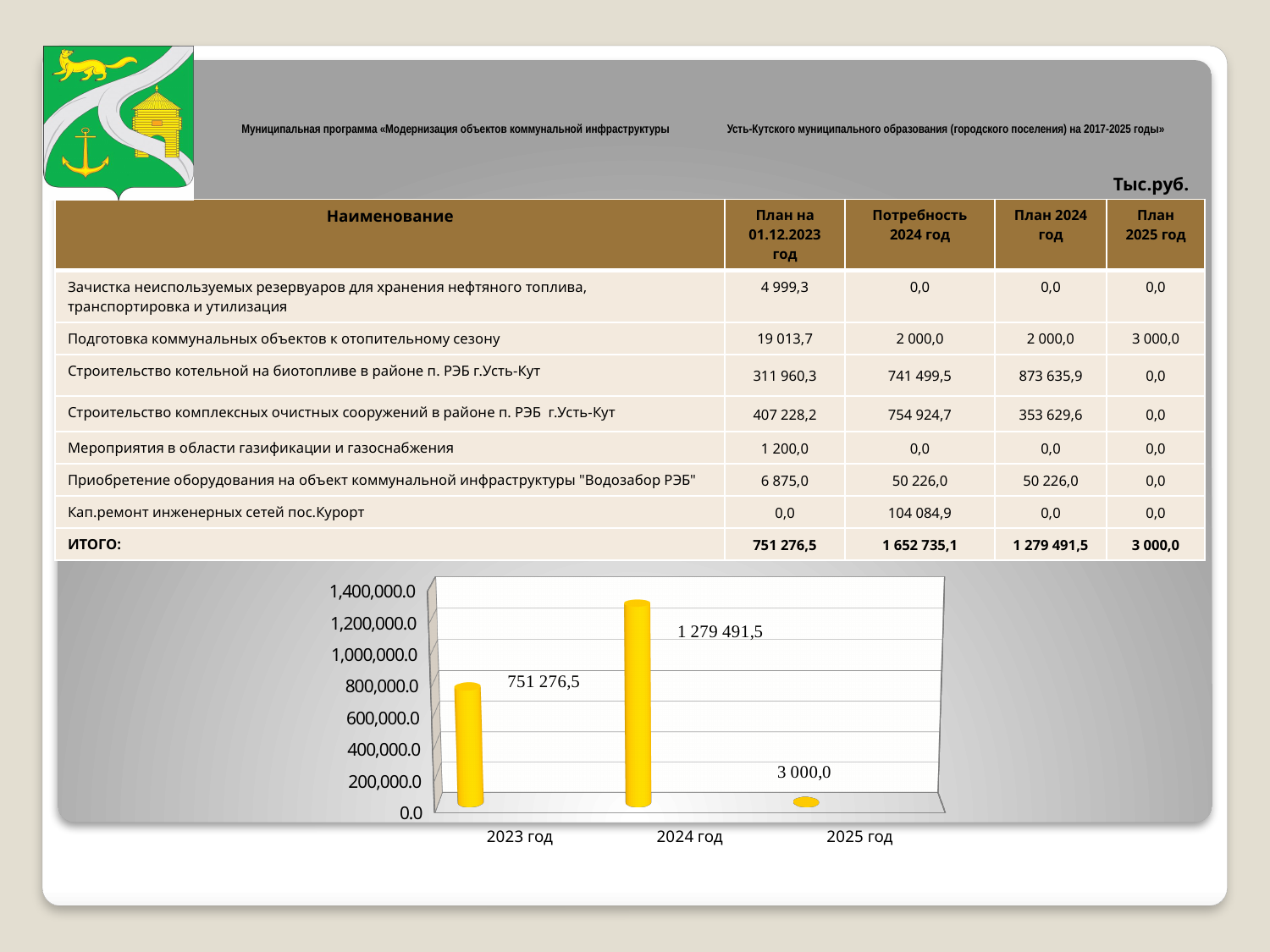
What is the value shown for 2025 год in the chart? 3 000,0 Which year has the lowest value in the chart? 2025 год What is the difference between the values for 2024 год and 2023 год in the chart? 528 215,0 Which year has the highest value in the chart? 2024 год What is the value shown for 2023 год in the chart? 751 276,5 What is the highest tick value shown on the vertical axis of the chart? 1,400,000.0 What is the value shown for 2024 год in the chart? 1 279 491,5 Is the value for 2024 год in the chart greater or less than 1,200,000.0? greater Is the value for 2023 год in the chart greater or less than 800,000.0? less What kind of chart is shown on the slide? bar chart Which is larger in the chart, the value for 2023 год or the value for 2025 год? 2023 год How many categories are plotted in the chart? 3